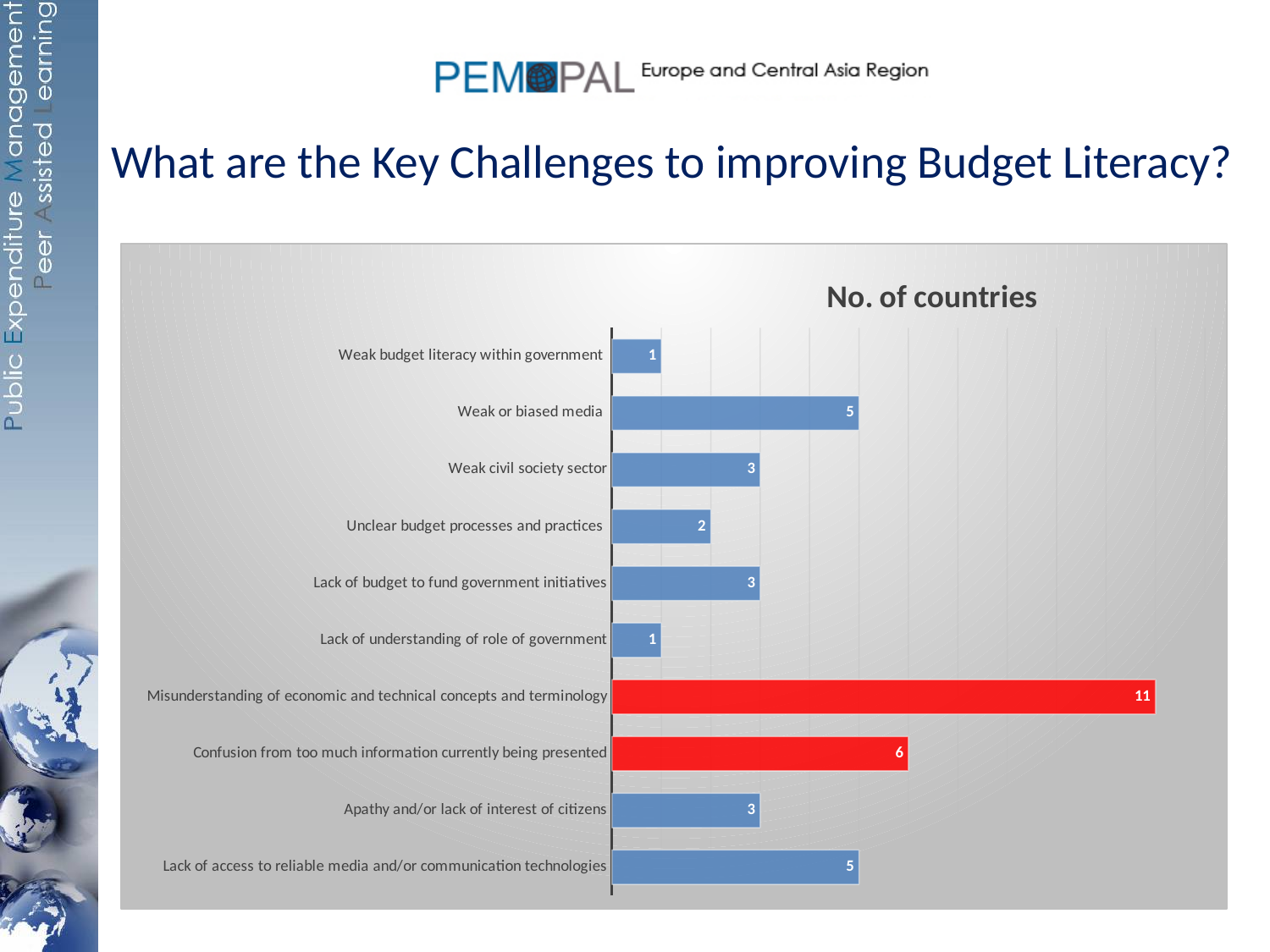
Which category has the highest number of countries? Misunderstanding of economic and technical concepts and terminology Which is larger: the value for 'Apathy and/or lack of interest of citizens' or the value for 'Weak budget literacy within government'? Apathy and/or lack of interest of citizens What is the value for 'Confusion from too much information currently being presented'? 6 What type of chart is shown on the slide? Bar chart What is the value for 'Misunderstanding of economic and technical concepts and terminology'? 11 What is the value for 'Lack of access to reliable media and/or communication technologies'? 5 What is the value for 'Unclear budget processes and practices'? 2 What is the difference between the values for 'Misunderstanding of economic and technical concepts and terminology' and 'Confusion from too much information currently being presented'? 5 What is the value for 'Weak or biased media'? 5 How many categories are shown in the chart? 10 What is the difference between the values for 'Weak or biased media' and 'Weak civil society sector'? 2 What is the title of the chart? No. of countries